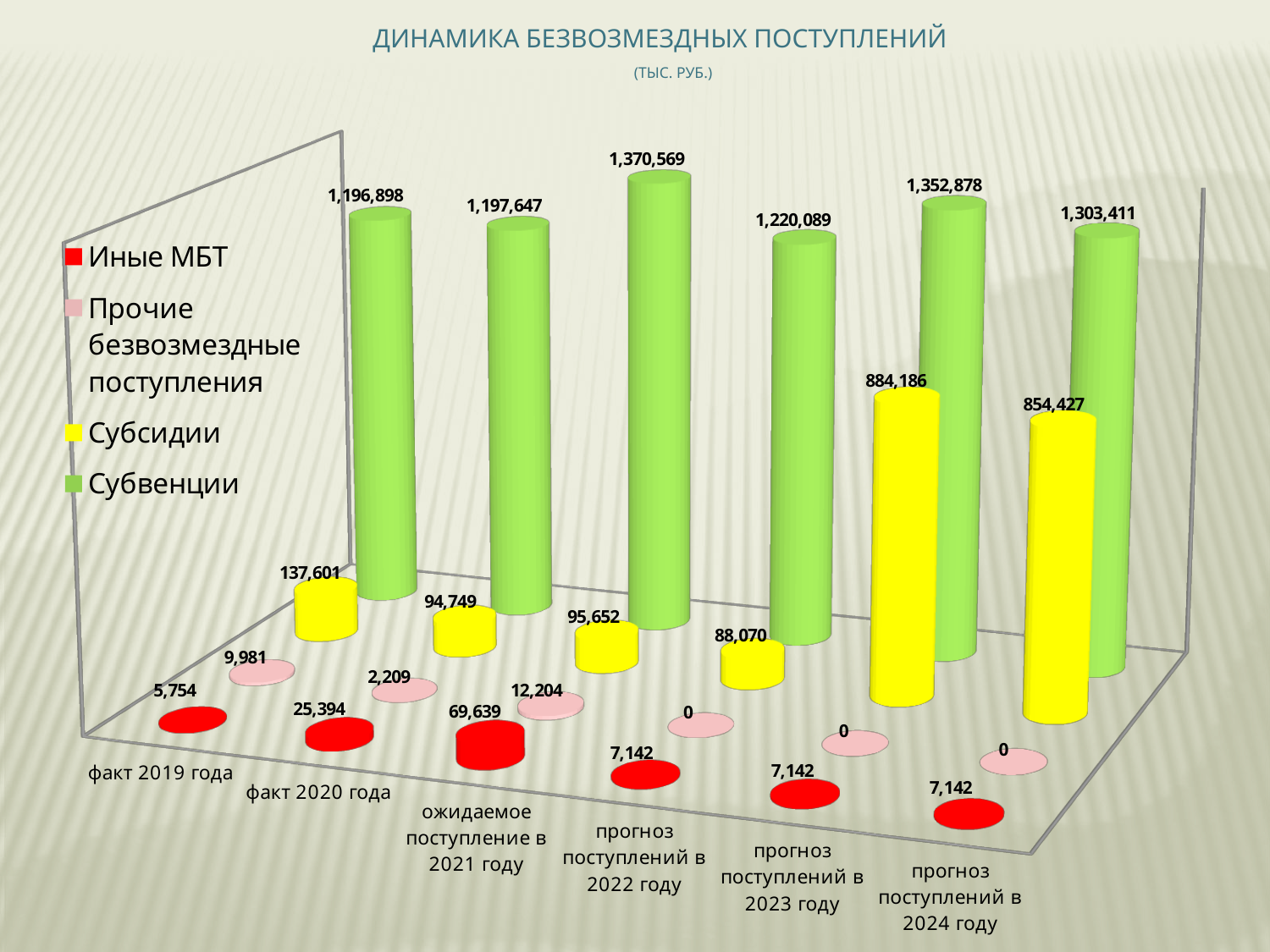
In which category is Субсидии lowest? прогноз поступлений в 2022 году How many series does the legend list? 4 What is the value of Субвенции for ожидаемое поступление в 2021 году? 1,370,569 In which category is Субвенции highest? ожидаемое поступление в 2021 году Which is larger: Иные МБТ for ожидаемое поступление в 2021 году or Иные МБТ for факт 2020 года? ожидаемое поступление в 2021 году What kind of chart is shown on the slide? bar chart What unit is given under the chart title? тыс. руб. What is the value of Субсидии for факт 2019 года? 137,601 What is the value of Прочие безвозмездные поступления for прогноз поступлений в 2022 году? 0 What is the difference between Субсидии for прогноз поступлений в 2023 году and прогноз поступлений в 2024 году? 29,759 How many categories are shown on the x axis? 6 What is the value of Иные МБТ for факт 2020 года? 25,394